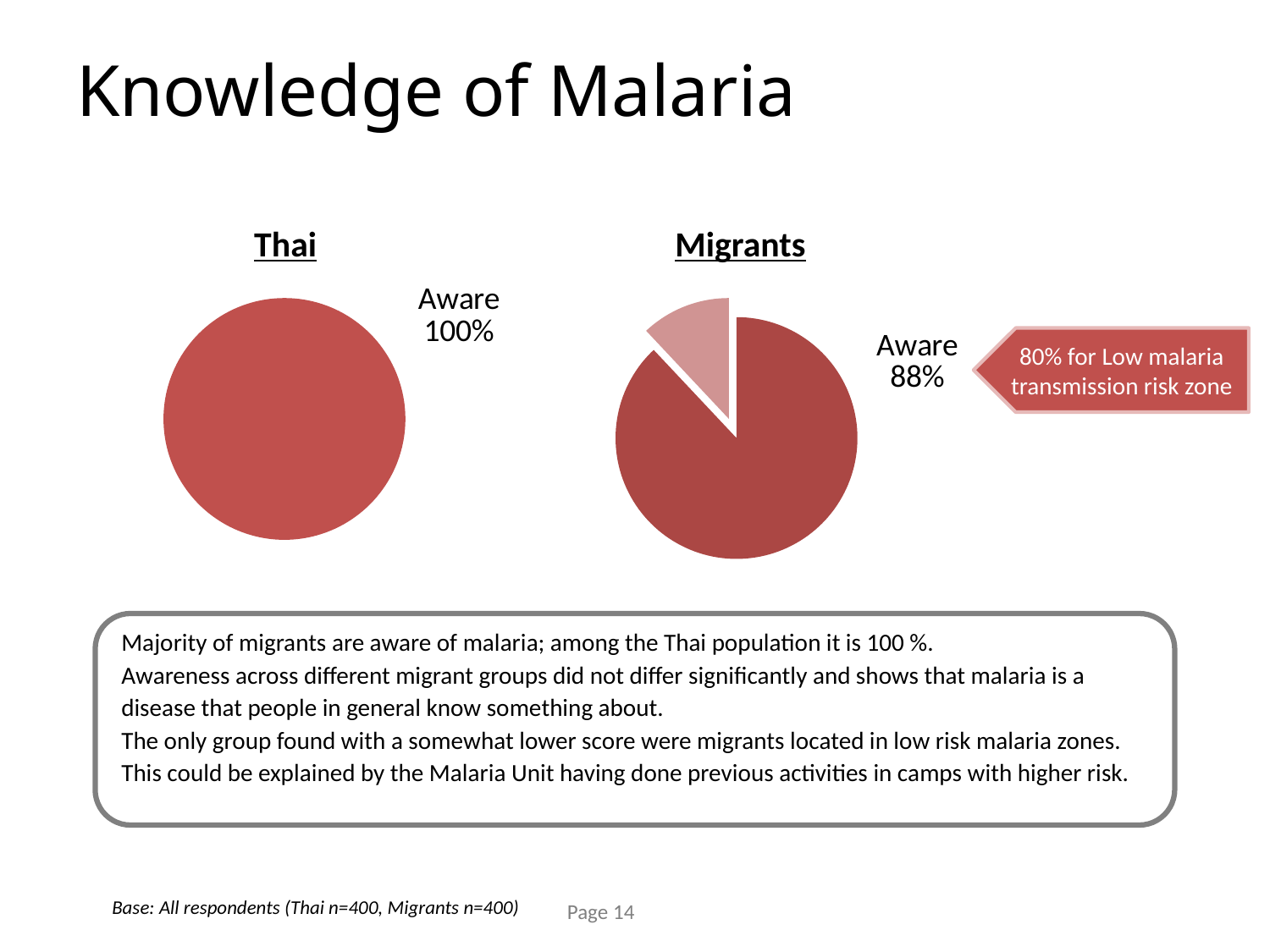
On the Thai pie chart, what percentage is labelled as Aware? 100% What is the difference between the Aware percentage for Thai and the Aware percentage for Migrants? 12 percentage points On the Migrants pie chart, what percentage is labelled as Aware? 88% What is the title of the pie chart on the right? Migrants Is the Aware value on the Migrants pie chart greater or less than 50%? greater Which group has the higher Aware percentage, Thai or Migrants? Thai What kind of chart is used to show awareness for the Migrants group? Pie chart On the Migrants pie chart, how many slices are shown? 2 What kind of chart is used to show awareness for the Thai group? Pie chart On the Thai pie chart, how many slices are shown? 1 How many pie charts are shown on the slide? 2 What is the title of the pie chart on the left? Thai